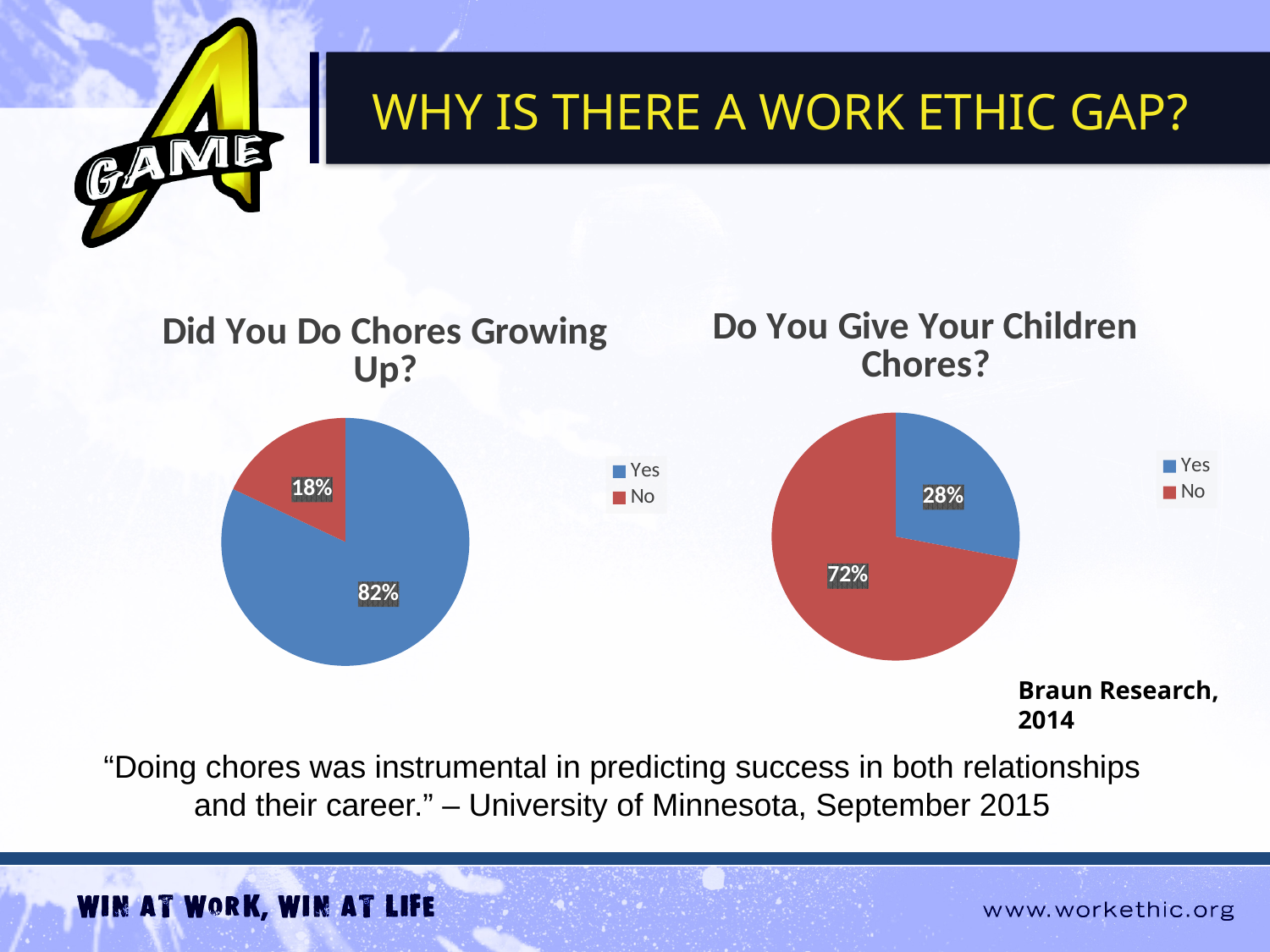
How many entries does the legend of the "Did You Do Chores Growing Up?" chart list? 2 In the "Did You Do Chores Growing Up?" chart, what percentage answered No? 18% In the "Do You Give Your Children Chores?" chart, what percentage answered Yes? 28% What type of chart is the "Do You Give Your Children Chores?" chart? Pie chart In the "Do You Give Your Children Chores?" chart, what is the difference between the No and Yes percentages? 44% In the "Do You Give Your Children Chores?" chart, which response has the smallest slice? Yes In the "Do You Give Your Children Chores?" chart, what percentage answered No? 72% Which is larger: the Yes share in the "Did You Do Chores Growing Up?" chart or the Yes share in the "Do You Give Your Children Chores?" chart? Did You Do Chores Growing Up? In the "Do You Give Your Children Chores?" chart, what colour is the No slice? Red In the "Did You Do Chores Growing Up?" chart, what is the difference between the Yes and No percentages? 64% In the "Did You Do Chores Growing Up?" chart, what percentage answered Yes? 82% In the "Did You Do Chores Growing Up?" chart, which response has the largest slice? Yes